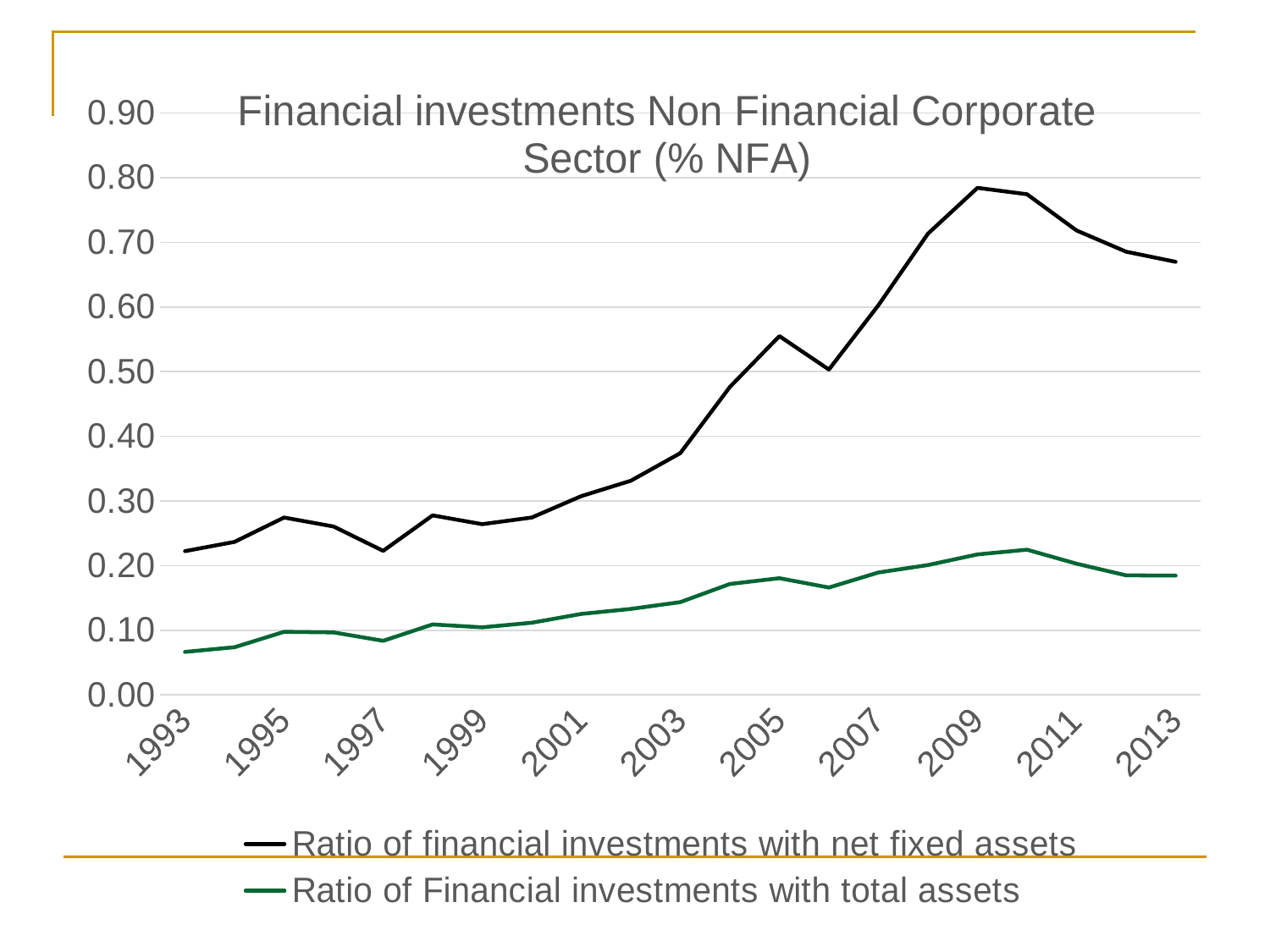
Does the ratio of financial investments with net fixed assets generally rise or fall between 1993 and 2009? rise In which labelled year does the ratio of financial investments with net fixed assets reach its highest value? 2009 How many year labels are shown on the x axis? 11 What kind of chart is shown on the slide? line chart Is the value of the ratio of financial investments with net fixed assets in 2013 greater or less than 0.70? less What is the title of the chart? Financial investments Non Financial Corporate Sector (% NFA) Which series is drawn in green? Ratio of Financial investments with total assets How many series does the legend list? 2 Is the value of the ratio of Financial investments with total assets in 1993 greater or less than 0.10? less Is the value of the ratio of financial investments with net fixed assets in 2005 greater or less than 0.50? greater In 2009, which series has the larger value: the ratio with net fixed assets or the ratio with total assets? Ratio of financial investments with net fixed assets